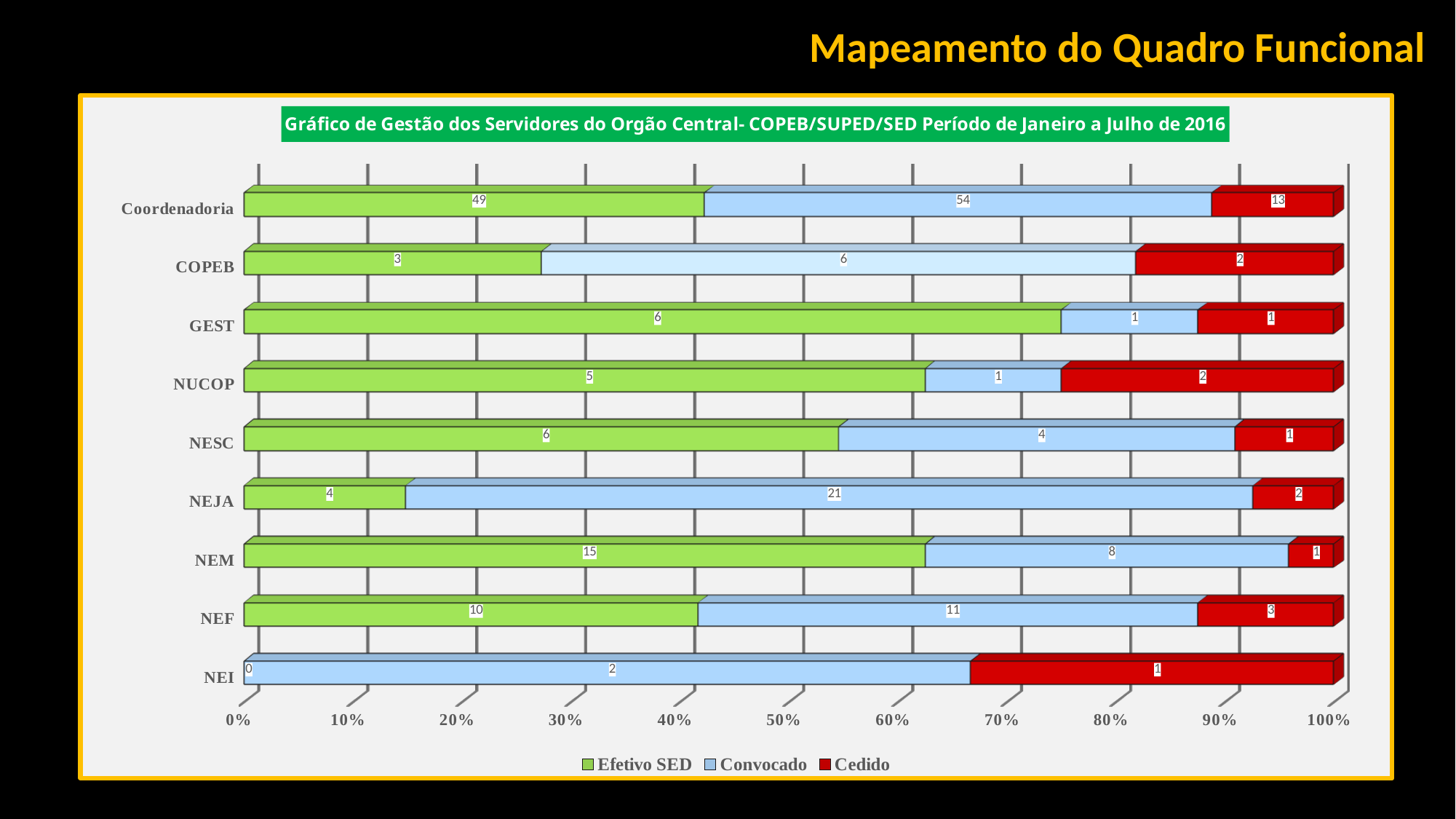
Which category has the lowest Efetivo SED value? NEI What is the Convocado value for NEJA? 21 How many categories are shown on the vertical axis? 9 What is the Efetivo SED value for Coordenadoria? 49 Which category has the highest Convocado value? Coordenadoria Which is larger for NEM: the Efetivo SED value or the Convocado value? Efetivo SED How many series does the legend list? 3 What is the difference between the Convocado and Efetivo SED values for Coordenadoria? 5 What is the Cedido value for NEF? 3 Which series is shown in red in the legend? Cedido What kind of chart is shown on the slide? Stacked bar chart What is the total of the three values in the NEJA bar? 27